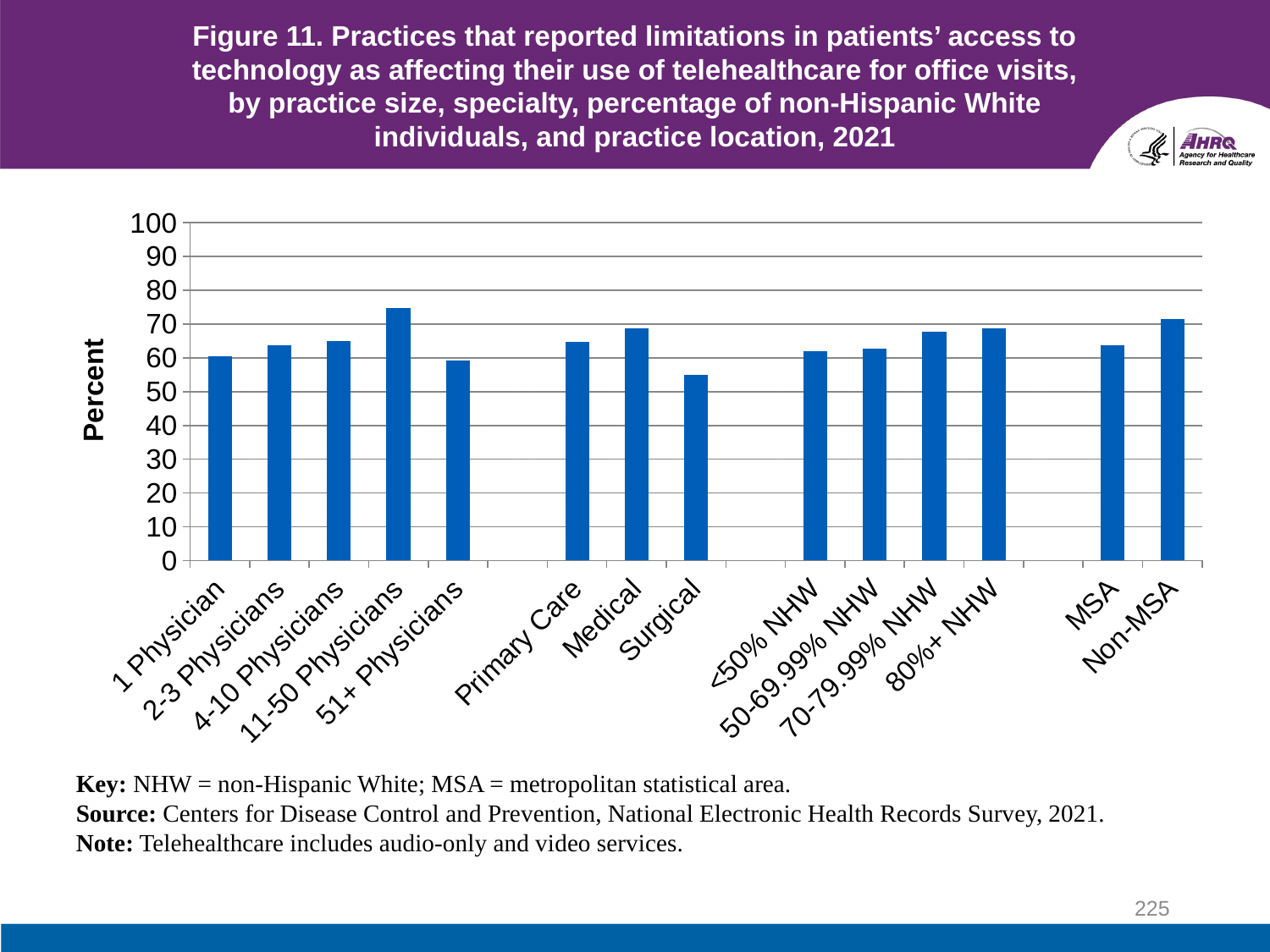
Which is larger, the value for Medical or the value for Surgical? Medical Which is larger, the value for 11-50 Physicians or the value for 51+ Physicians? 11-50 Physicians How many bars (categories) are plotted in the chart? 14 Which category has the lowest value in the chart? Surgical What is the label on the vertical axis of the chart? Percent Is the value for 1 Physician greater or less than 50? greater What kind of chart is shown on the slide? bar chart Is the value for Non-MSA greater or less than 70? greater Which category has the highest value in the chart? 11-50 Physicians Is the value for 11-50 Physicians greater or less than 70? greater Which is larger, the value for MSA or the value for Non-MSA? Non-MSA